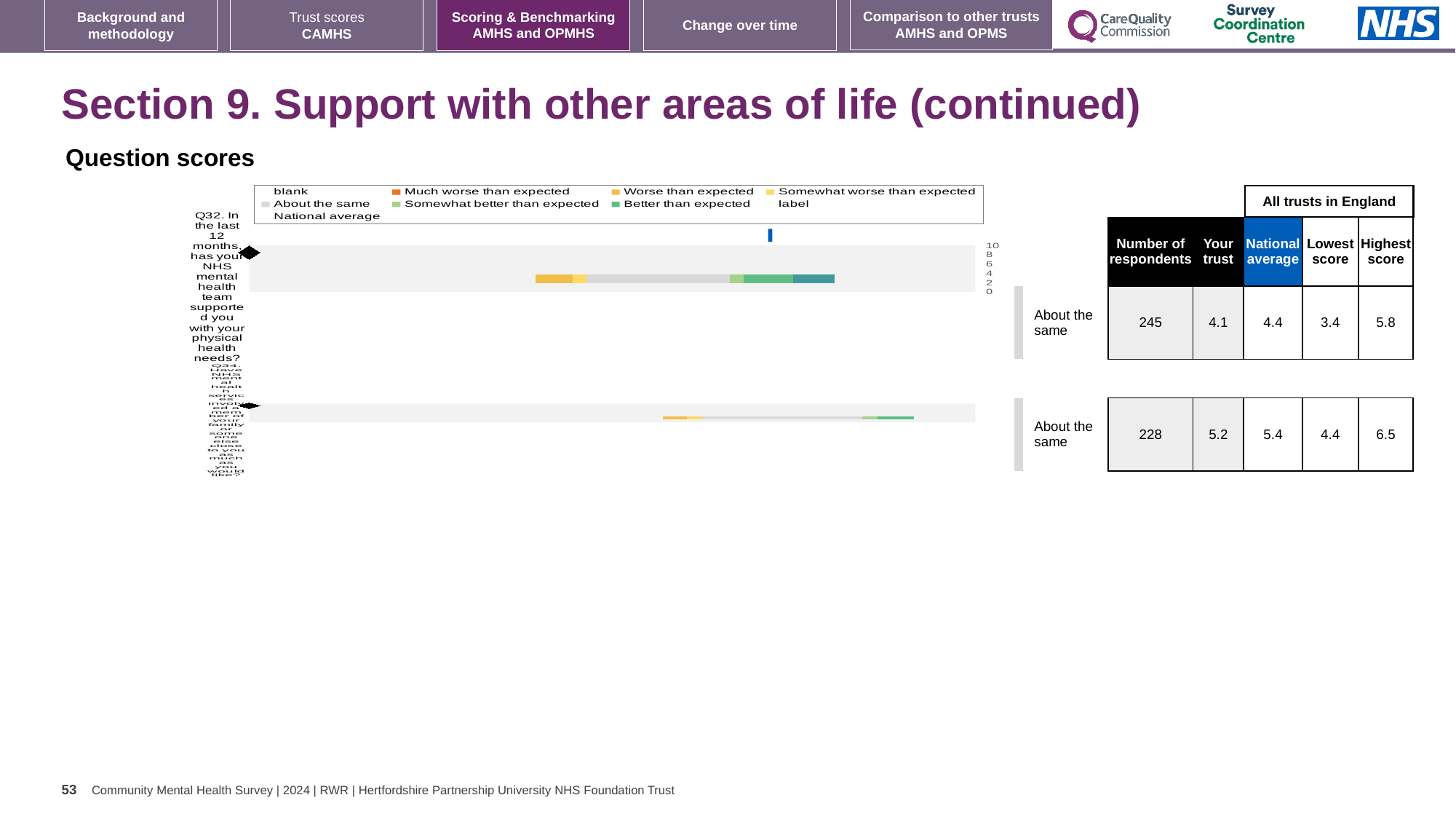
What kind of chart is used to show the question scores on this slide? bar chart How many questions (categories) are plotted in the question scores chart? 2 What is the difference between the highest score and the lowest score for Q34? 2.1 What is the 'Your trust' score for Q32 (support with physical health needs)? 4.1 What is the highest score among all trusts in England for Q34? 6.5 What is the highest tick value shown on the chart's score axis? 10 How is the trust's Q32 score categorised relative to expectation? About the same How many respondents answered Q32? 245 Which question has the higher 'Your trust' score, Q32 or Q34? Q34 What colour represents 'Much worse than expected' in the chart legend? orange For Q32, which is higher: the trust's score or the national average? National average What is the national average score for Q34 (involving family or someone close)? 5.4